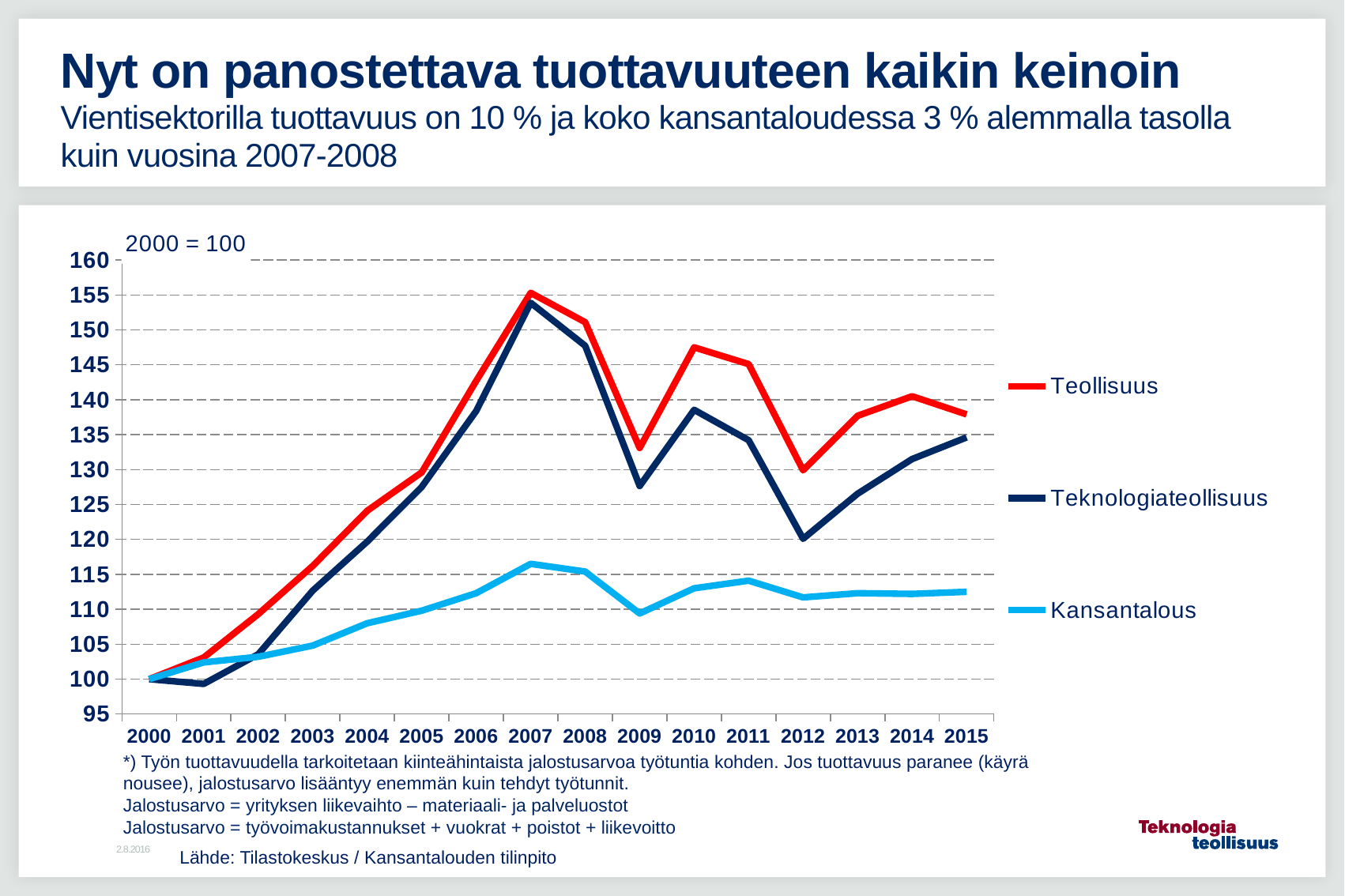
Is the value for Teollisuus in 2007 greater or less than 150? greater Is the value for Kansantalous in 2015 greater or less than 110? greater Is the value for Teknologiateollisuus in 2012 greater or less than 125? less In which year does the Teollisuus line reach its highest value? 2007 What is the value of Teollisuus in 2000? 100 What kind of chart is shown on the slide? line chart How many years are shown on the x axis? 16 What colour is the Teollisuus line in the legend? red In which year does the Teknologiateollisuus line reach its highest value? 2007 How many series does the legend list? 3 Which is larger in 2010, Teollisuus or Kansantalous? Teollisuus Does the Teollisuus line rise or fall between 2007 and 2009? fall